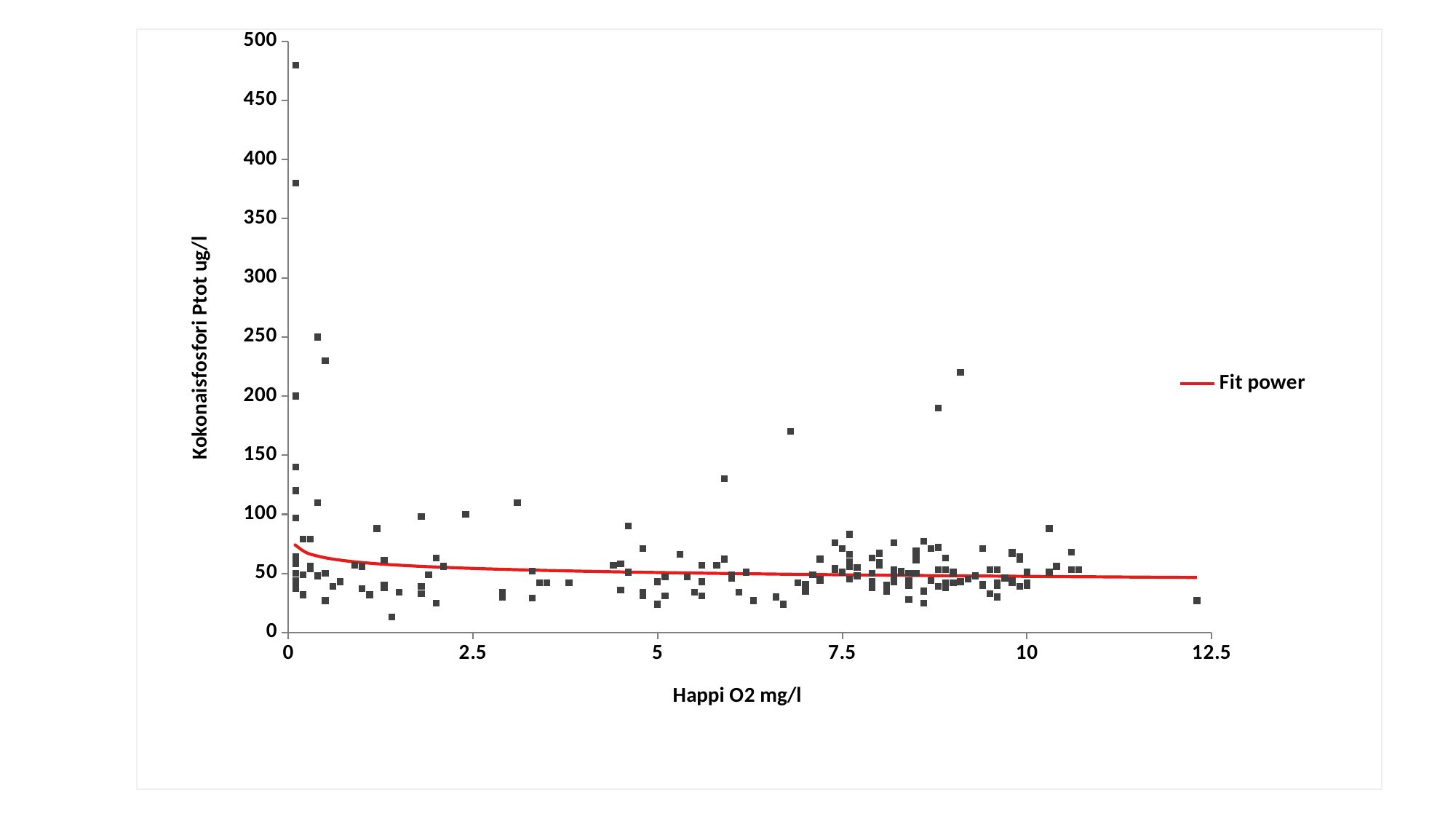
Does the red fit line rise or fall as Happi O2 increases along the x axis? fall Is the highest plotted point with Happi O2 between 7.5 and 10 greater or less than 200 on the y axis? greater What kind of chart is shown on the slide? scatter chart Is the value of the red fit line at the left end of the chart (near Happi O2 = 0) greater or less than 50? greater Is the highest plotted point on the chart greater or less than 450 on the y axis? greater How many entries does the legend list? 1 What is the maximum value shown on the y axis? 500 What is the title of the x axis? Happi O2 mg/l What is the title of the y axis? Kokonaisfosfori Ptot ug/l